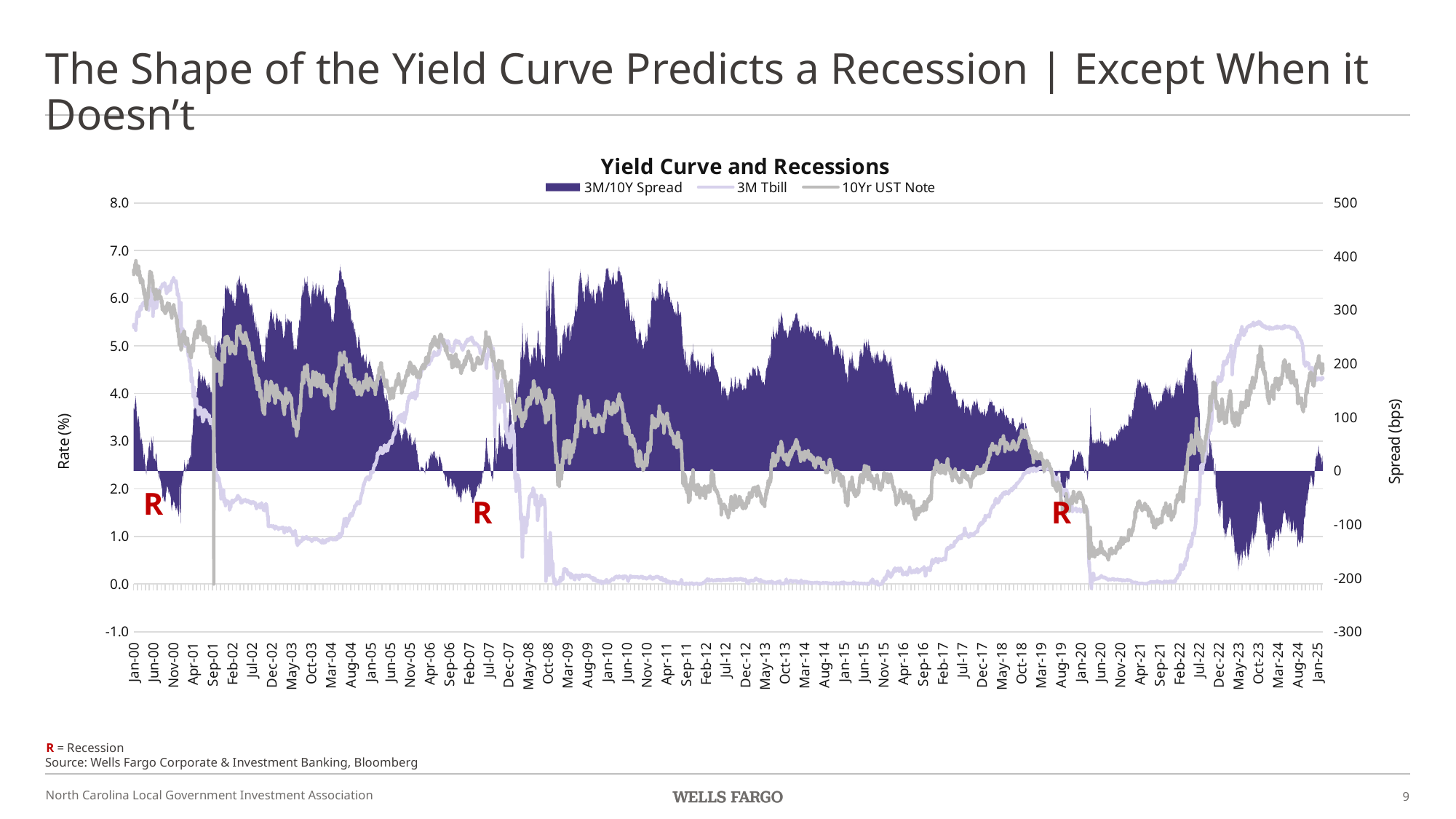
Is the 10Yr UST Note value at Jul-12 greater or less than 2.0? less What is the title of the chart on the slide? Yield Curve and Recessions Does the 10Yr UST Note rise or fall between Jan-00 and Jun-03? fall Is the 3M Tbill value at Jan-10 greater or less than 1.0? less Is the 10Yr UST Note value at Jan-00 greater or less than 6.0? greater How many recession markers (R) are shown on the chart? 3 Which series are listed in the chart's legend? 3M/10Y Spread, 3M Tbill, 10Yr UST Note How many series does the chart's legend list? 3 Does the 3M Tbill rise or fall between Jan-22 and Oct-23? rise